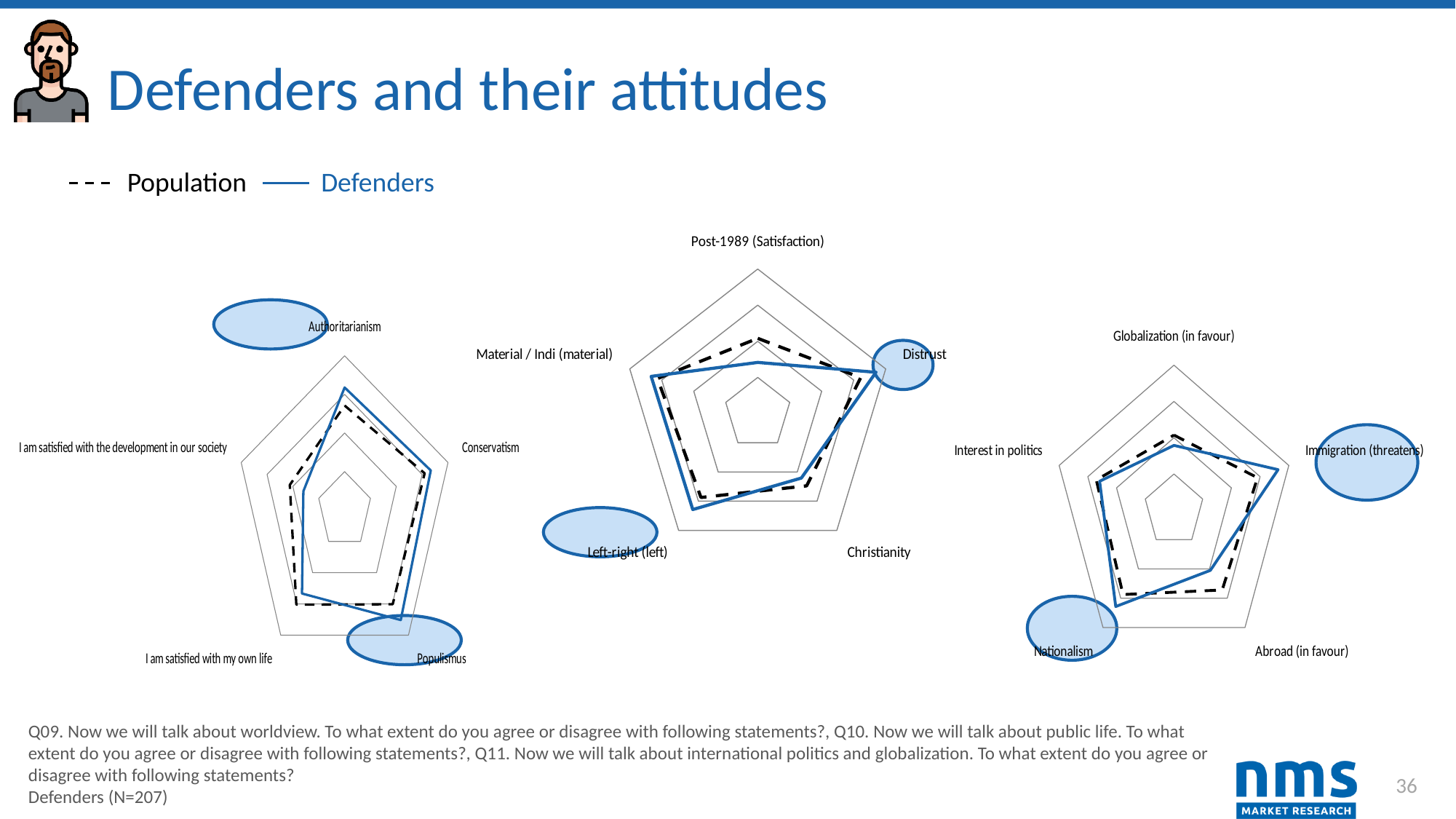
In the right chart, which category has the highest value for Defenders? Immigration (threatens) How many series does the legend list? 2 In the right chart, for Nationalism, which series has the larger value: Population or Defenders? Defenders Which two series are shown in the legend? Population and Defenders In the right chart, which category has the lowest value for Defenders? Globalization (in favour) How many radar charts are on the slide? 3 In the middle chart, for Post-1989 (Satisfaction), which series has the larger value: Population or Defenders? Population In the left chart, for Populismus, which series has the larger value: Population or Defenders? Defenders In the middle chart, which category has the highest value for Defenders? Distrust In the left chart, how many axes (categories) are plotted? 5 In the left chart, which category has the highest value for Defenders? Populismus What kind of chart is used on this slide? Radar chart